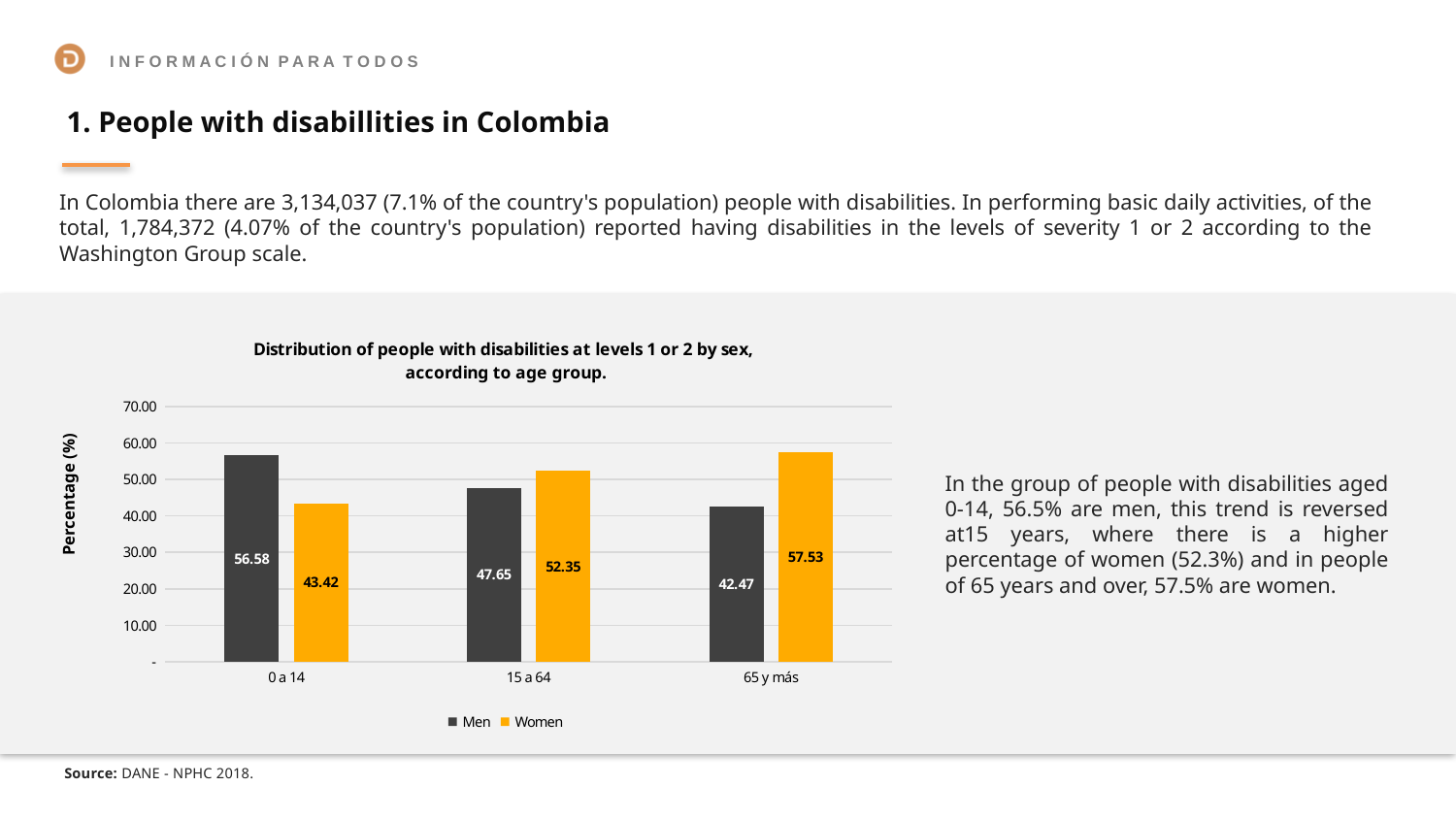
Which age group has the highest value for Women? 65 y más Which age group has the lowest value for Men? 65 y más Is the value for Men in the 15 a 64 age group greater or less than 50.00? less How many series does the legend list? 2 In the 0 a 14 age group, which is larger, the value for Men or for Women? Men What kind of chart is shown on the slide? Bar chart Do the values for Men rise or fall across the age groups from left to right? Fall What is the value for Women in the 65 y más age group? 57.53 What is the value for Women in the 15 a 64 age group? 52.35 What is the difference between the Women and Men values in the 65 y más age group? 15.06 What is the value for Men in the 0 a 14 age group? 56.58 How many age groups are shown on the x axis? 3